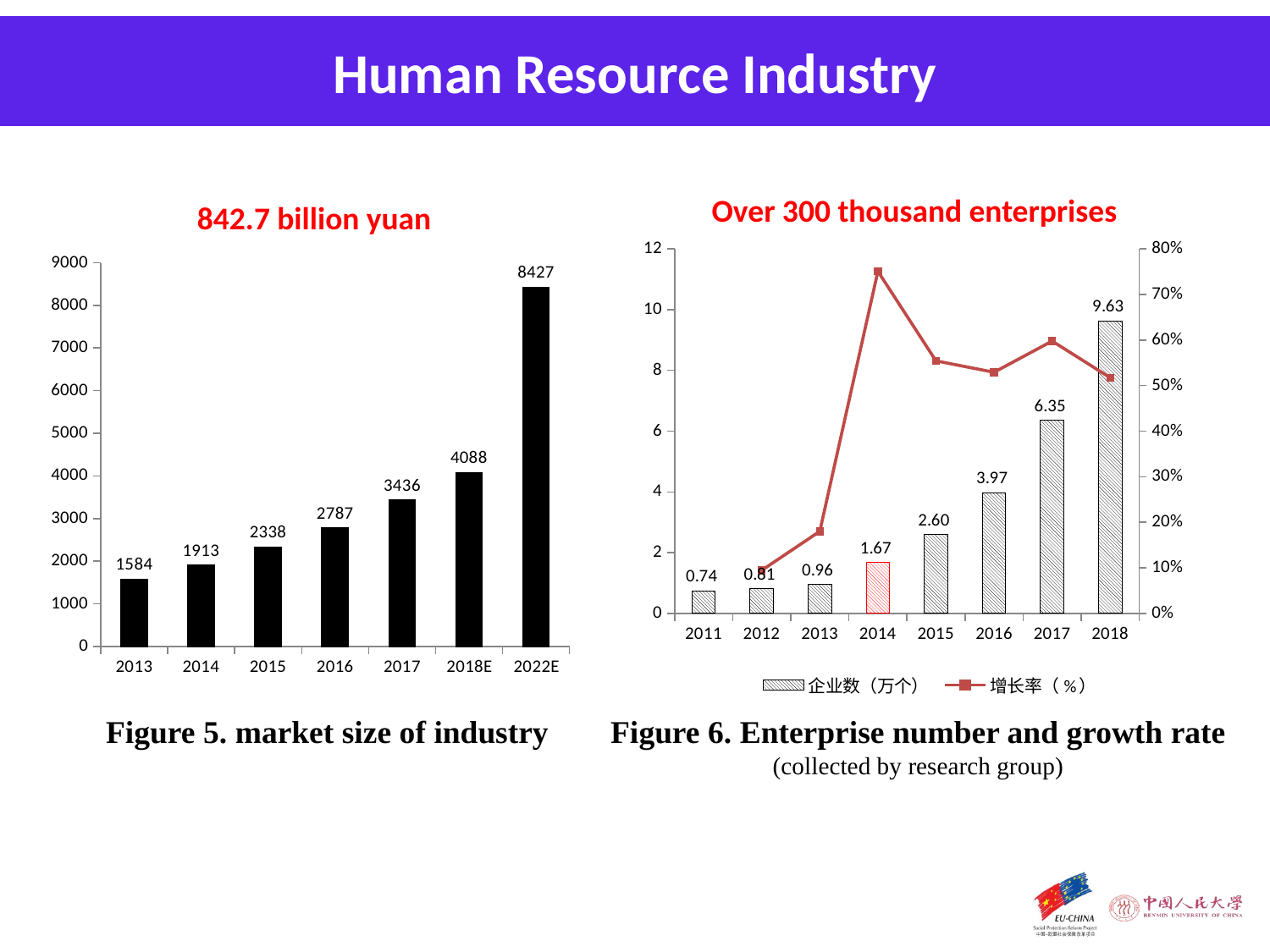
In Figure 6 (Enterprise number and growth rate), what is the enterprise number value for 2016? 3.97 What kind of chart is Figure 5 (market size of industry)? bar chart In Figure 6 (Enterprise number and growth rate), what is the difference between the enterprise number values for 2018 and 2017? 3.28 In Figure 6 (Enterprise number and growth rate), which year has the lowest enterprise number? 2011 In Figure 5 (market size of industry), what is the difference between the values for 2018E and 2017? 652 In Figure 6 (Enterprise number and growth rate), is the growth rate for 2014 greater or less than 70%? greater In Figure 5 (market size of industry), do the values rise or fall from 2013 to 2022E? rise In Figure 5 (market size of industry), what is the value for 2017? 3436 In Figure 6 (Enterprise number and growth rate), which is larger, the enterprise number for 2015 or for 2013? 2015 In Figure 6 (Enterprise number and growth rate), how many series does the legend list? 2 In Figure 5 (market size of industry), how many years are shown on the x axis? 7 In Figure 5 (market size of industry), which year has the highest value? 2022E